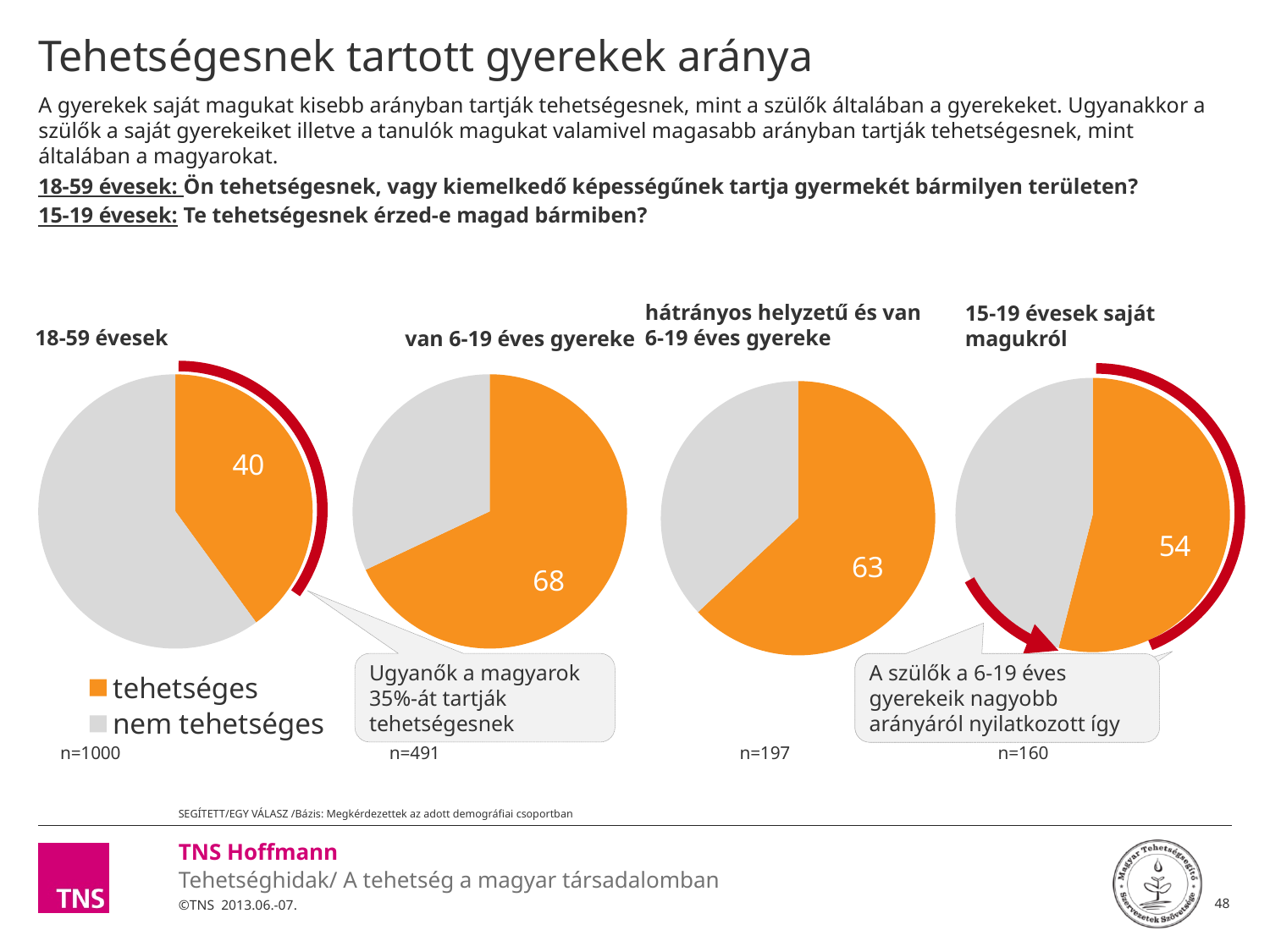
How many entries does the legend list? 2 In the pie chart titled "hátrányos helyzetű és van 6-19 éves gyereke", what value is shown for the "tehetséges" slice? 63 In the pie chart titled "18-59 évesek", what value is shown for the "tehetséges" slice? 40 Which of the four pie charts shows the highest "tehetséges" value? van 6-19 éves gyereke Is the "tehetséges" value larger in the "hátrányos helyzetű és van 6-19 éves gyereke" chart or in the "15-19 évesek saját magukról" chart? hátrányos helyzetű és van 6-19 éves gyereke Which of the four pie charts shows the lowest "tehetséges" value? 18-59 évesek How many pie charts are shown on the slide? 4 In the pie chart titled "15-19 évesek saját magukról", what value is shown for the "tehetséges" slice? 54 What type of chart is used on this slide? pie chart What is the difference between the "tehetséges" value in the "van 6-19 éves gyereke" chart and the "18-59 évesek" chart? 28 Which colour represents "nem tehetséges" in the legend? grey In the pie chart titled "van 6-19 éves gyereke", what value is shown for the "tehetséges" slice? 68